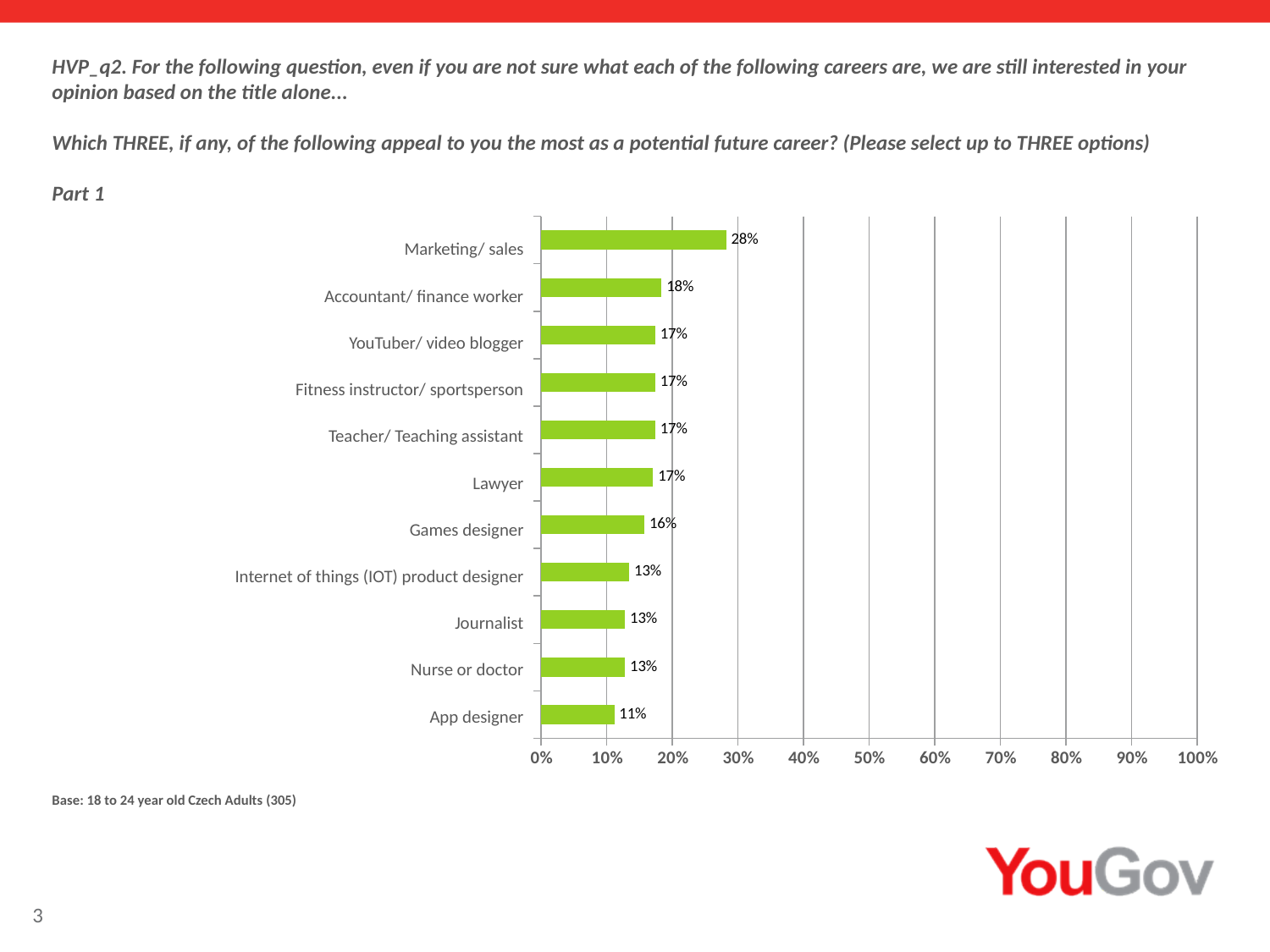
What is the difference in percentage points between Marketing/ sales and Accountant/ finance worker? 10 percentage points What percentage is shown for App designer? 11% What type of chart is shown on the slide? Bar chart Is the value for Marketing/ sales greater or less than 20%? greater Which has a higher value, Lawyer or Journalist? Lawyer What is the value for Accountant/ finance worker? 18% Which career has the highest percentage on the chart? Marketing/ sales What is the value shown for Games designer? 16% What percentage of respondents chose Marketing/ sales as an appealing future career? 28% How many career categories are shown on the chart? 11 Which career has the lowest percentage on the chart? App designer What is the difference between the values for Games designer and App designer? 5 percentage points